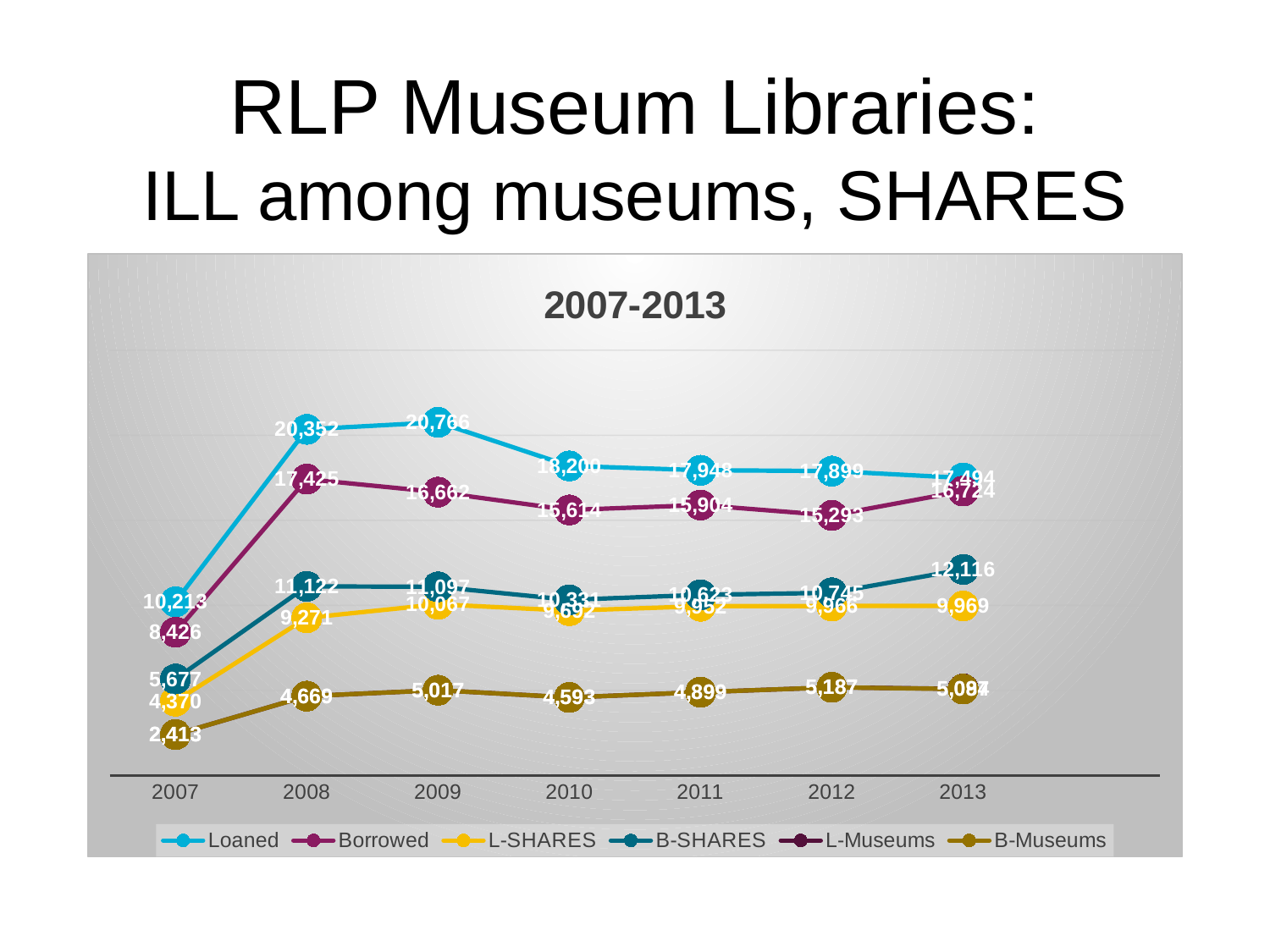
What is the Borrowed value for 2008? 17,425 By how much did the Loaned value increase from 2007 to 2008? 10,139 What is the B-SHARES value for 2013? 12,116 What kind of chart is shown on the slide? line chart How many years are plotted along the x axis? 7 What is the L-SHARES value for 2009? 10,067 What is the Loaned value for 2009? 20,766 In 2013, which is larger, Loaned or Borrowed? Loaned Does the Loaned series rise or fall from 2009 to 2013? fall How many series does the legend list? 6 In which year is the Loaned value lowest? 2007 In which year is the Loaned value highest? 2009